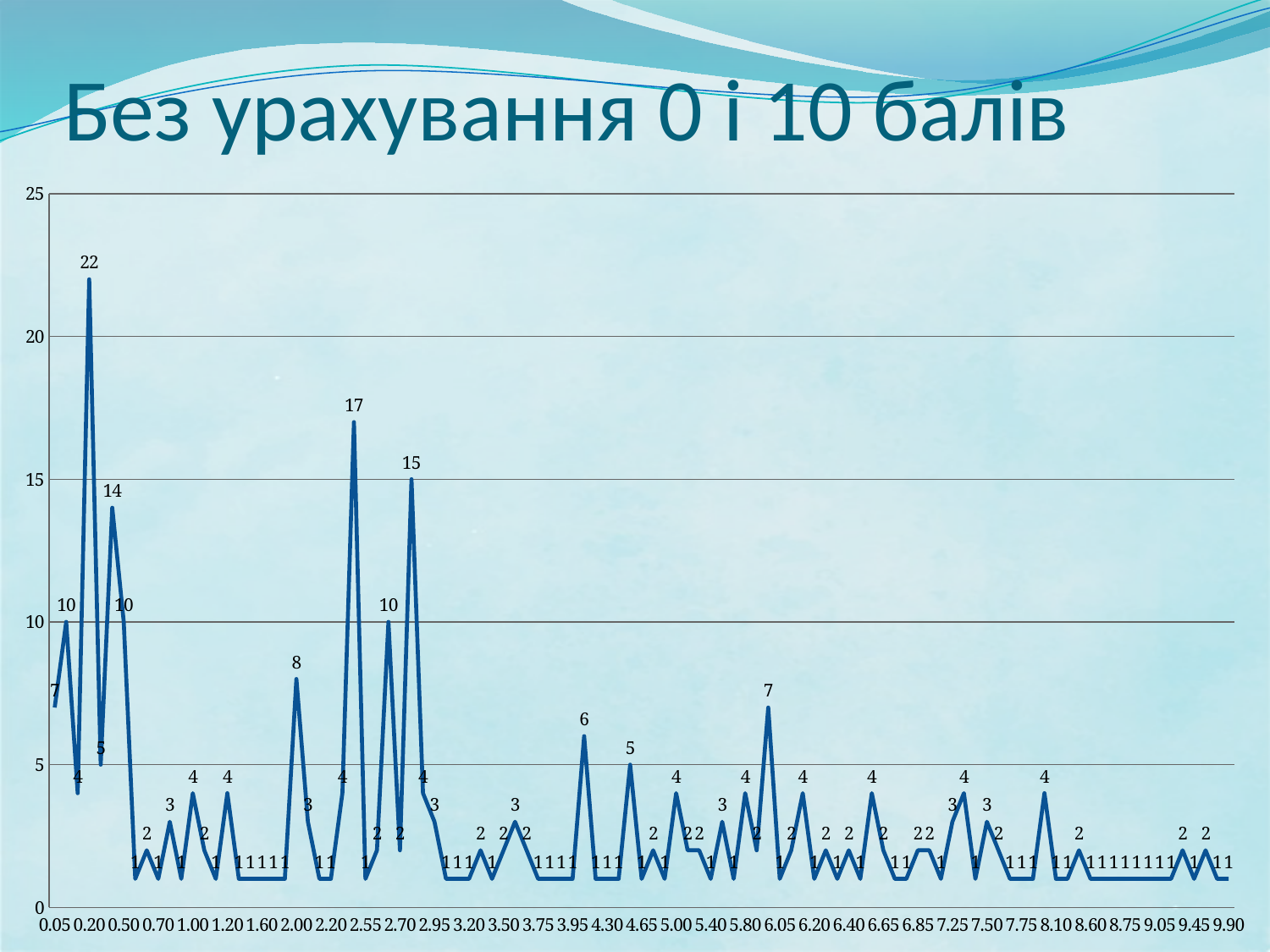
What is the value at 6.05? 1 What is the value at 2.55? 1 Which is larger, the value at 2.55 or the value at 2.70? 2.70 What is the value at 2.00? 8 What type of chart is shown on the slide? line chart What is the title of the chart? Без урахування 0 і 10 балів What is the value at 0.20? 22 What is the difference between the value at 0.20 and the value at 2.55? 21 What is the lowest value plotted on the chart? 1 Is the value at 0.05 greater or less than 5? greater What is the highest value plotted on the chart? 22 What is the value at 2.70? 2